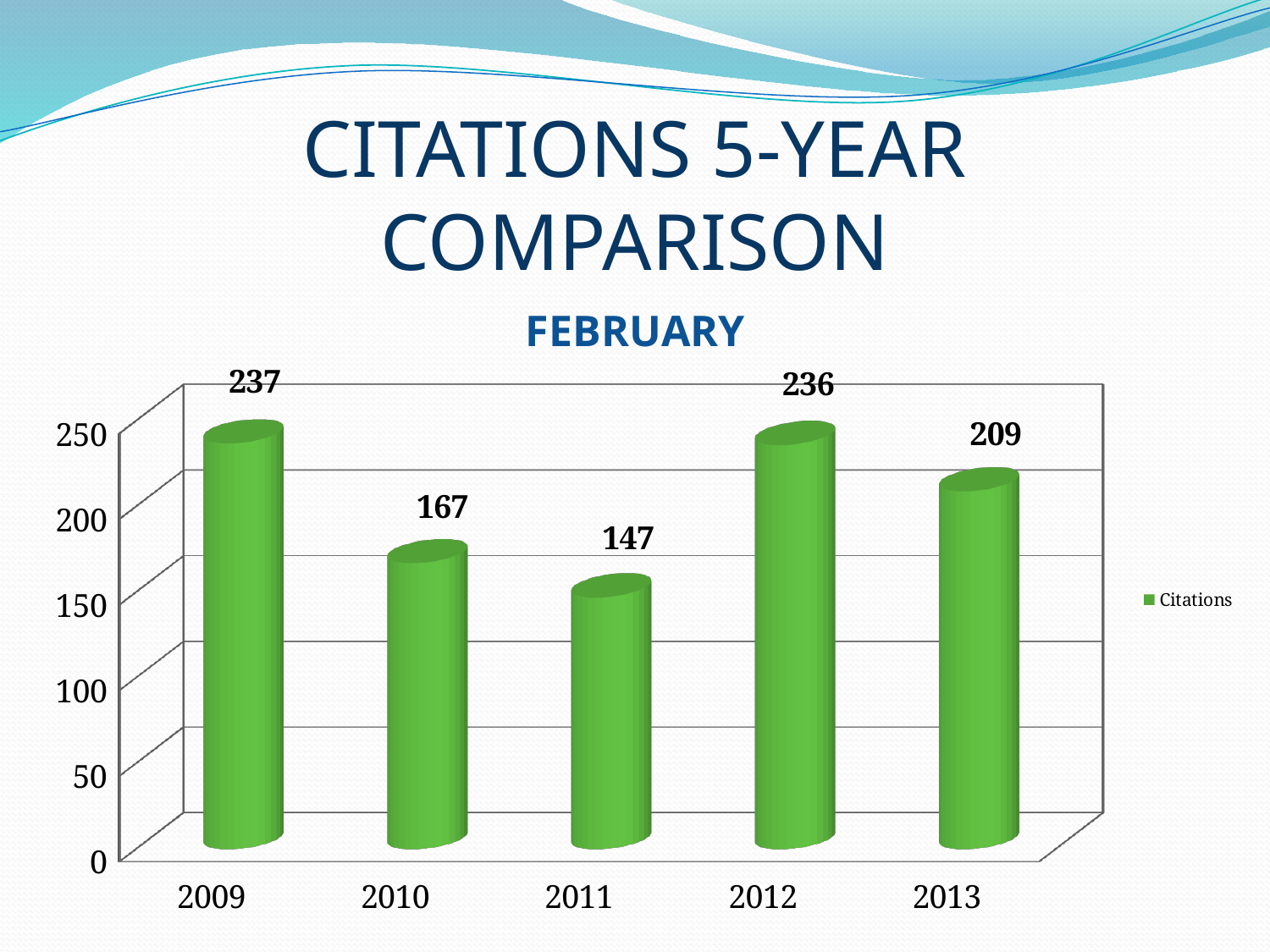
What is the value for 2013? 209 How many citations were there in February 2009? 237 What is the value for 2011? 147 Which year has the lowest number of citations? 2011 What kind of chart is shown on the slide? bar chart What is the difference between the values for 2009 and 2013? 28 Which year has the highest number of citations? 2009 How many years are shown on the x axis? 5 What is the difference between the values for 2012 and 2010? 69 How many series does the legend list? 1 Which is larger, the value for 2010 or the value for 2013? 2013 What is the title of the chart? FEBRUARY